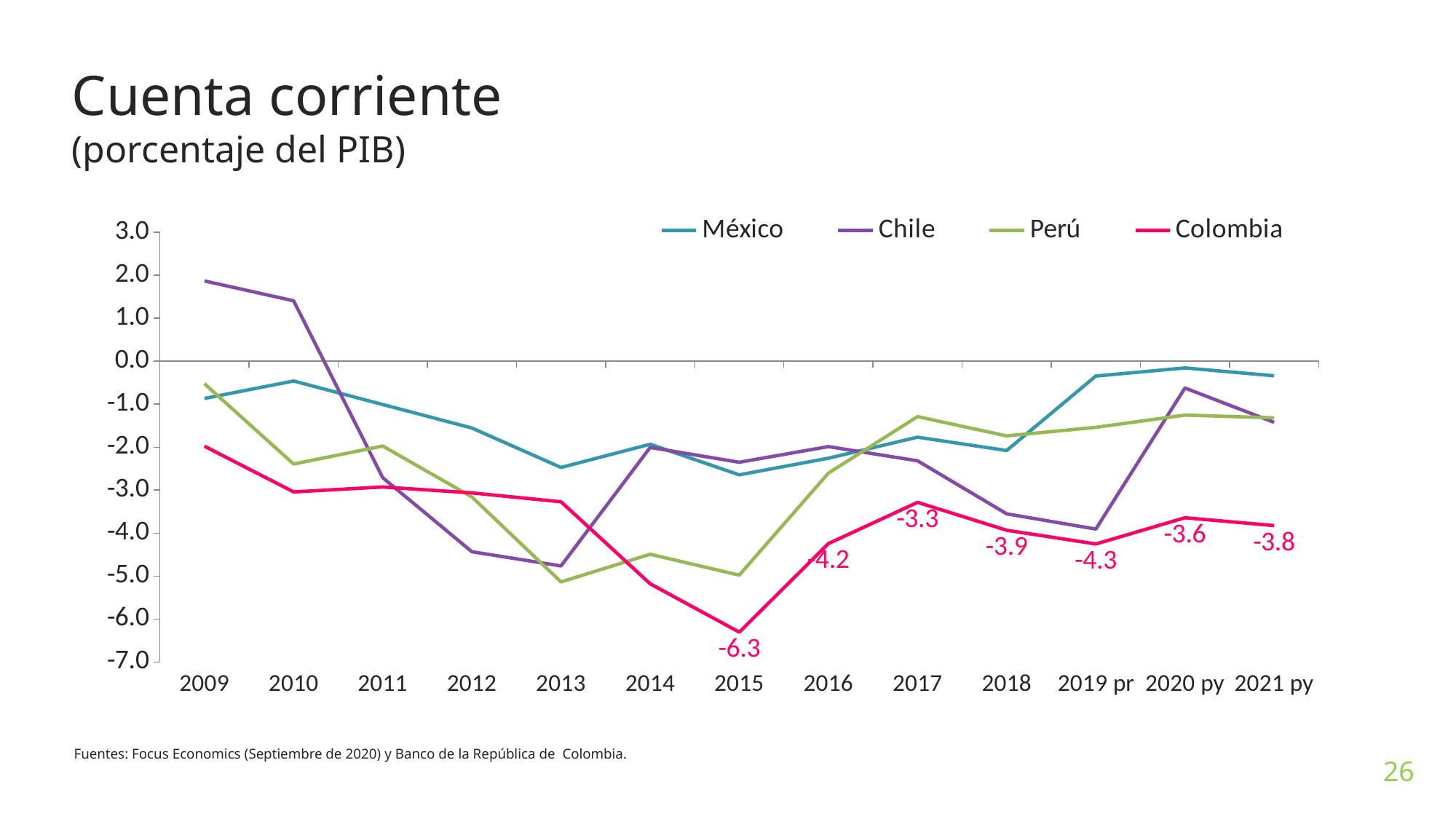
What is the value for Colombia in 2019 pr? -4.3 In which year does Colombia reach its lowest value? 2015 How many series does the legend list? 4 Which of Colombia's labelled values is larger: 2017 or 2019 pr? 2017 What type of chart is shown on the slide? line chart What is the value for Colombia in 2015? -6.3 What is the value for Colombia in 2021 py? -3.8 By how much did Colombia's value change between 2015 and 2016? 2.1 How many years (points) are shown along the x axis? 13 Is the value for Perú in 2013 greater or less than -4.0? less What is the title of the chart? Cuenta corriente (porcentaje del PIB) Is the value for Chile in 2009 greater or less than 1.0? greater